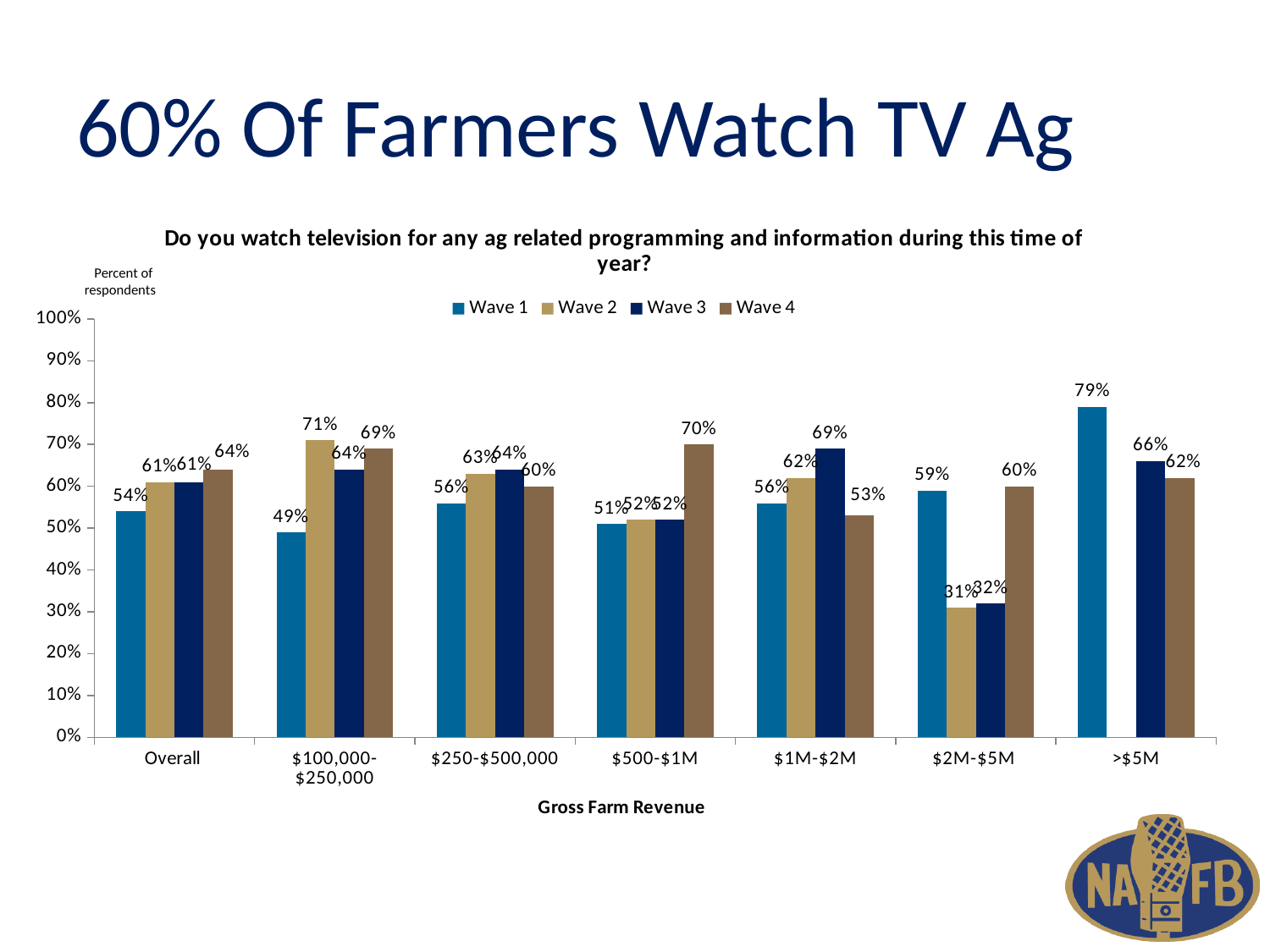
What is the Wave 2 value for the $2M-$5M category? 31% Which category is missing a Wave 2 bar? >$5M What is the Wave 1 value for the Overall category? 54% How many series does the legend list? 4 How many gross farm revenue categories are shown on the x axis? 7 Which gross farm revenue category has the lowest Wave 2 value? $2M-$5M What is the difference between the Wave 4 and Wave 1 values for the $100,000-$250,000 category? 20% Which gross farm revenue category has the highest Wave 1 value? >$5M What kind of chart is shown on the slide? Bar chart What is the x-axis title of the chart? Gross Farm Revenue What is the Wave 4 value for the $500-$1M category? 70% For the $1M-$2M category, which is larger, the Wave 3 value or the Wave 4 value? Wave 3